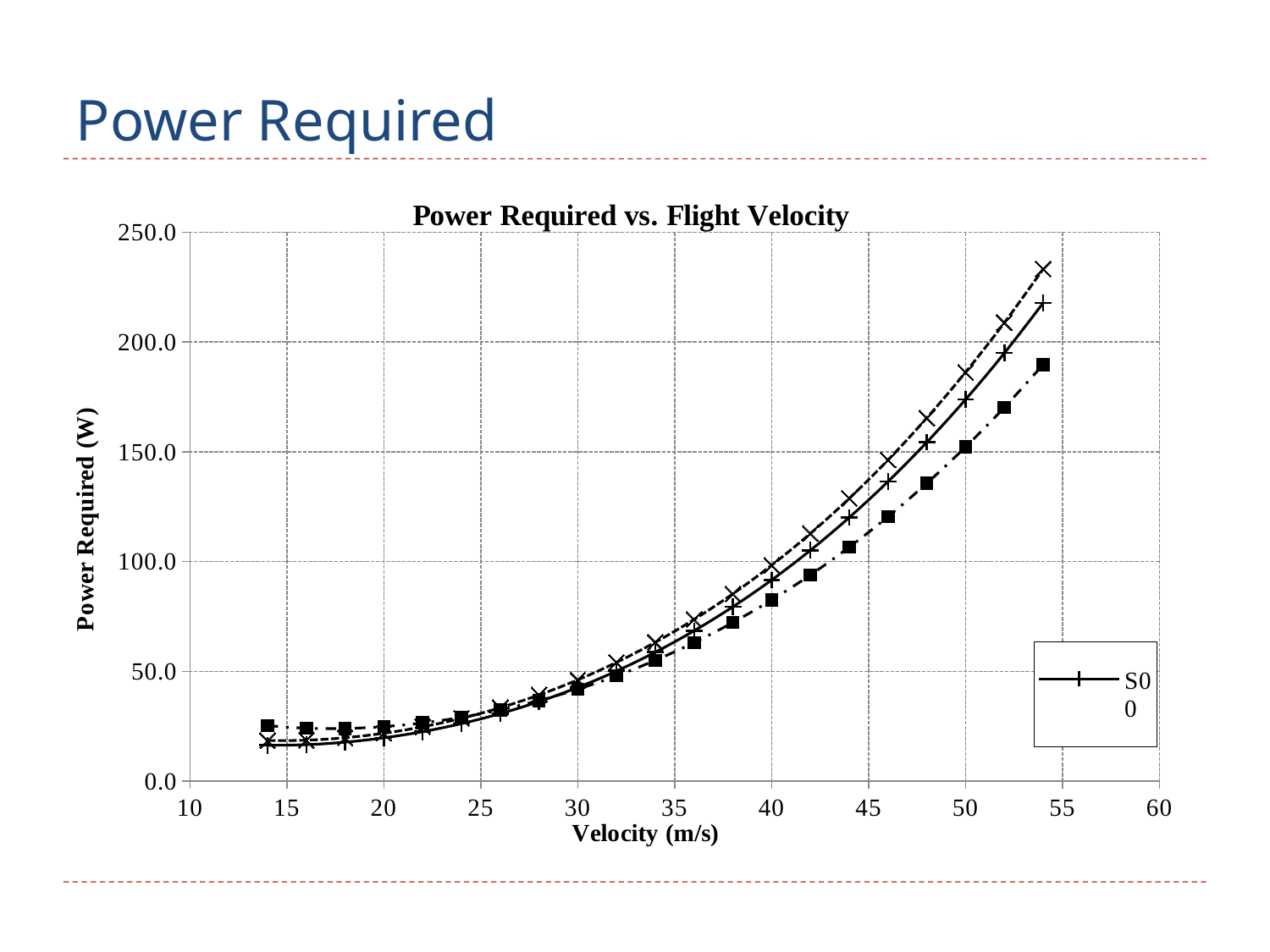
Which series has the highest power required at 54 m/s? the x-marker (dashed) series How many lines (series) are plotted on the chart? 3 How many data points does the square-marker series have? 21 Is the value of the square-marker series at 40 m/s greater or less than 100.0? less What is the label of the y axis? Power Required (W) What kind of chart is shown on the slide? line chart Is the value of the square-marker series at 54 m/s greater or less than 200.0? less At 14 m/s, which is larger: the square-marker series or the x-marker series? the square-marker series Do the power required values rise or fall as velocity increases along the x axis? rise What is the title of the chart? Power Required vs. Flight Velocity Which series has the lowest power required at 54 m/s? the square-marker (dash-dot) series Is the value of the x-marker series at 54 m/s greater or less than 200.0? greater